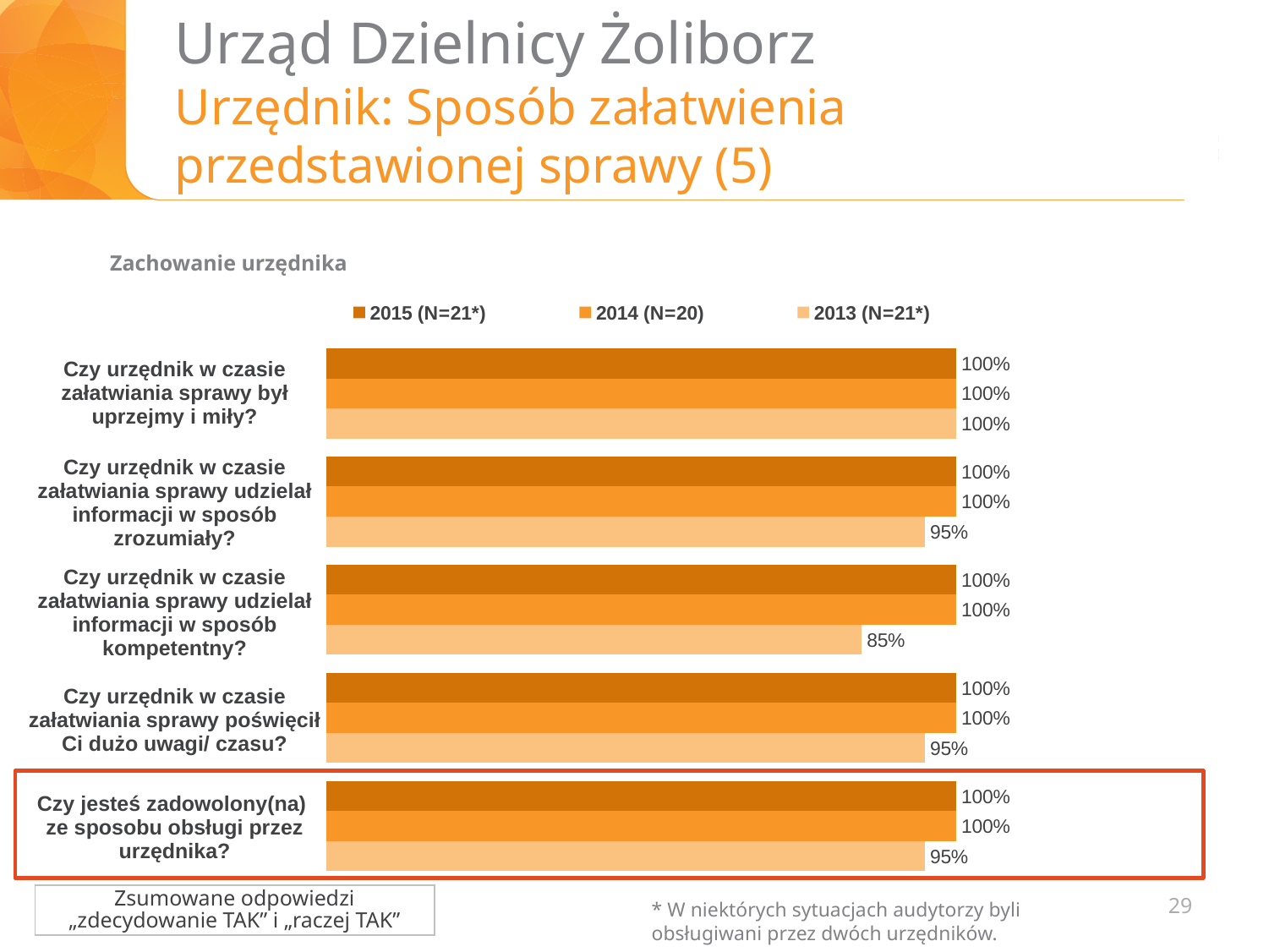
What is the 2013 (N=21*) value for "Czy urzędnik w czasie załatwiania sprawy udzielał informacji w sposób zrozumiały?" 95% For "Czy jesteś zadowolony(na) ze sposobu obsługi przez urzędnika?", which is larger: the 2015 (N=21*) value or the 2013 (N=21*) value? 2015 (N=21*) What is the difference between the 2014 (N=20) and 2013 (N=21*) values for "Czy urzędnik w czasie załatwiania sprawy udzielał informacji w sposób kompetentny?" 15% What is the 2013 (N=21*) value for "Czy urzędnik w czasie załatwiania sprawy udzielał informacji w sposób kompetentny?" 85% How many question categories are plotted on the chart? 5 Which category has the lowest 2013 (N=21*) value? Czy urzędnik w czasie załatwiania sprawy udzielał informacji w sposób kompetentny? What is the difference between the 2015 (N=21*) and 2013 (N=21*) values for "Czy urzędnik w czasie załatwiania sprawy poświęcił Ci dużo uwagi/ czasu?" 5% What is the 2015 (N=21*) value for "Czy jesteś zadowolony(na) ze sposobu obsługi przez urzędnika?" 100% What is the 2014 (N=20) value for "Czy urzędnik w czasie załatwiania sprawy poświęcił Ci dużo uwagi/ czasu?" 100% What is the title of the chart? Zachowanie urzędnika What kind of chart is shown on the slide? bar chart How many series does the legend list? 3